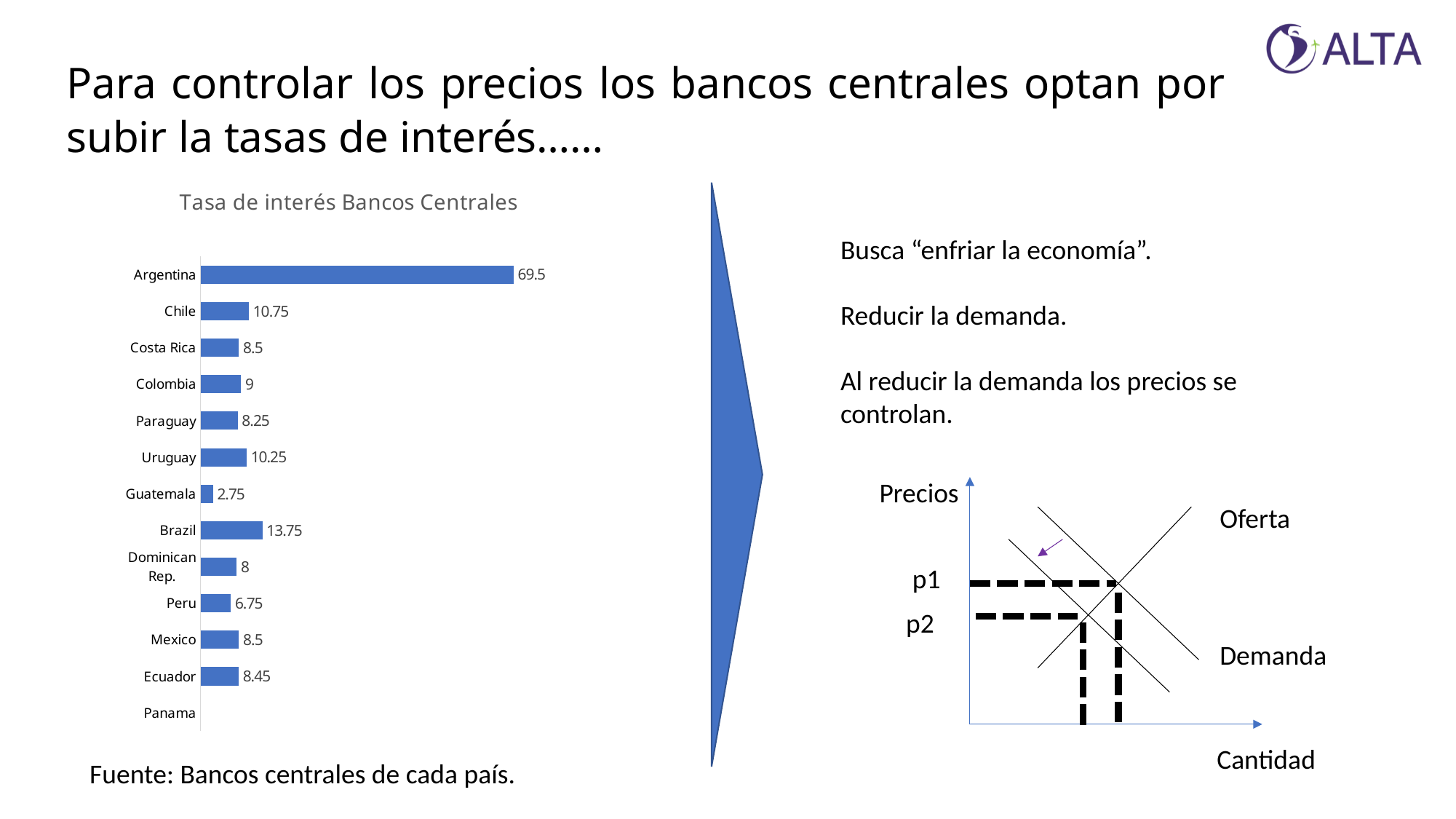
Which has a higher value, Peru or Colombia? Colombia What is the value shown for Dominican Rep.? 8 Which country has the highest interest rate in the chart? Argentina What is the title of the bar chart? Tasa de interés Bancos Centrales What is the value shown for Brazil? 13.75 Which has a higher value, Brazil or Chile? Brazil What is the interest rate shown for Argentina? 69.5 What is the value shown for Guatemala? 2.75 Among the countries with a bar shown, which has the lowest interest rate? Guatemala What is the difference between the values for Chile and Uruguay? 0.5 How many countries are listed on the chart's axis? 13 What type of chart is 'Tasa de interés Bancos Centrales'? bar chart